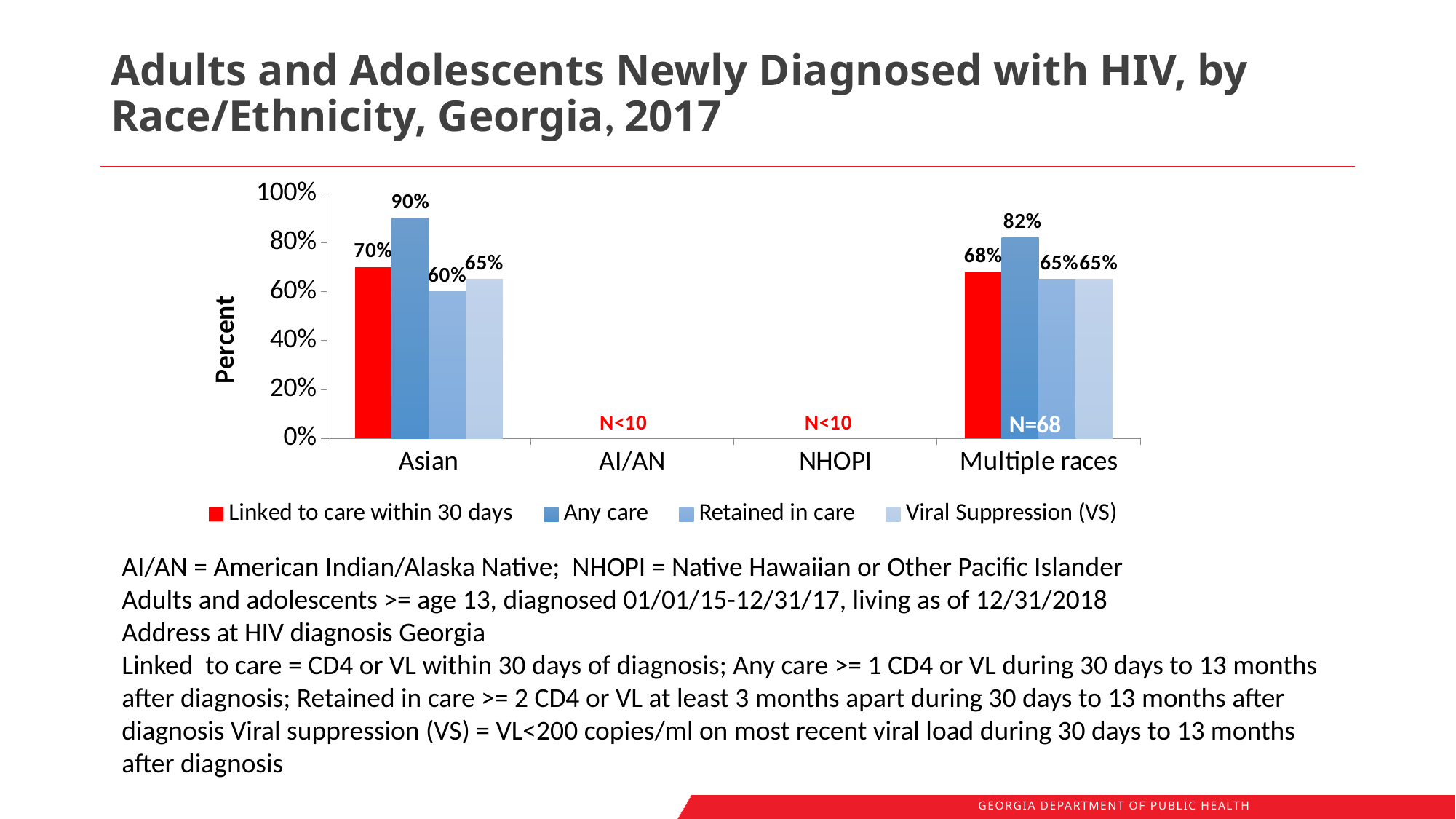
Which is larger: Linked to care within 30 days for Asian or for Multiple races? Asian What is the value for Linked to care within 30 days in the Multiple races category? 68% What is the difference between Any care for Asian and Any care for Multiple races? 8% What is the value for Any care in the Asian category? 90% What is the difference between Any care and Linked to care within 30 days in the Asian category? 20% Which series has the highest value in the Asian category? Any care What is the value for Retained in care in the Asian category? 60% What label is shown for the AI/AN and NHOPI categories instead of bars? N<10 Which series has the lowest value in the Asian category? Retained in care What kind of chart is shown on the slide? Bar chart How many series does the legend list? 4 What is the value for Viral Suppression (VS) in the Multiple races category? 65%